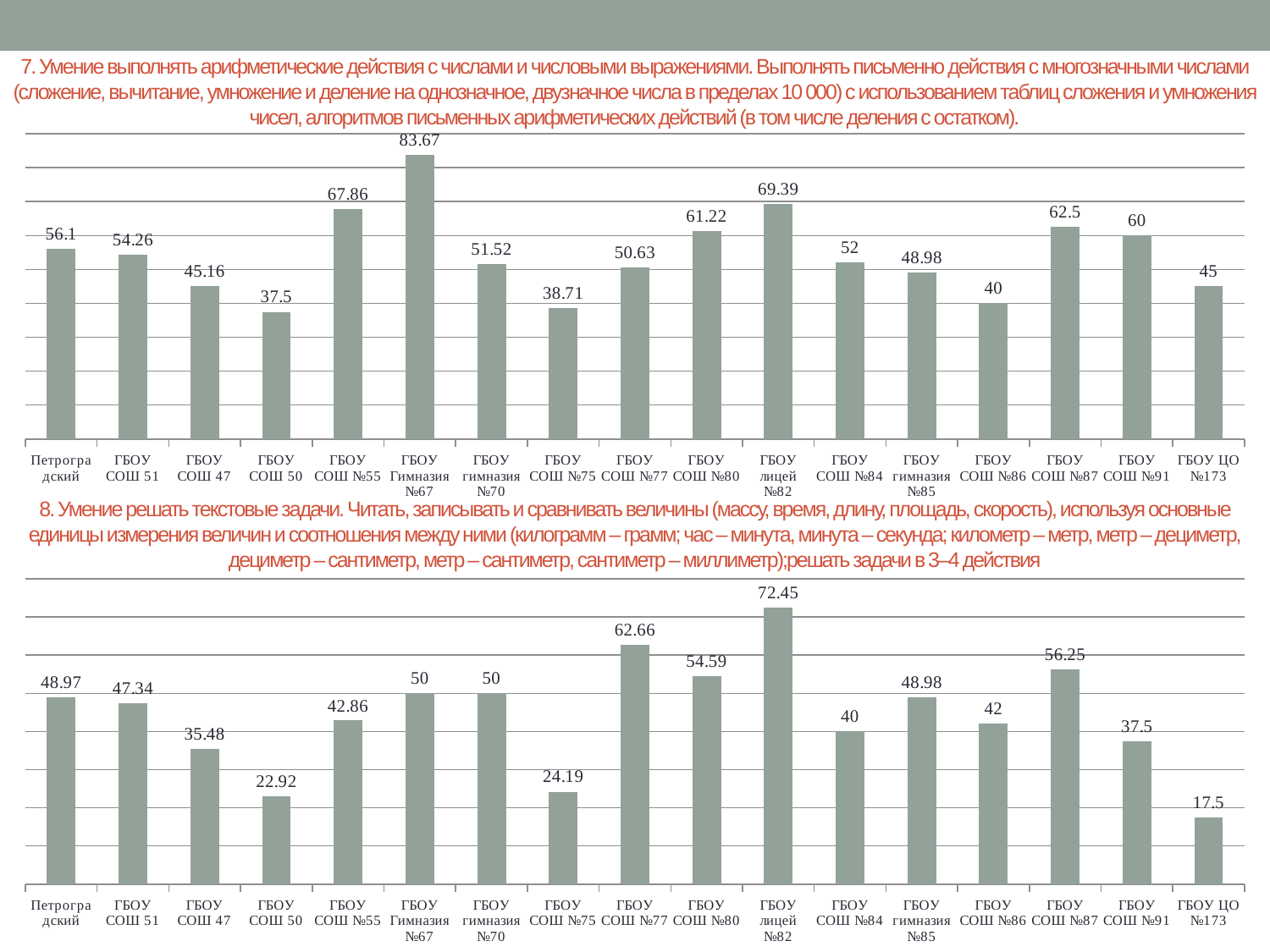
How many schools (categories) are shown in the top chart? 17 In the bottom chart, which school has the lowest value? ГБОУ ЦО №173 In the bottom chart, what is the difference between the values for ГБОУ СОШ №77 and ГБОУ СОШ №75? 38.47 In the top chart, what is the value for ГБОУ Гимназия №67? 83.67 What type of chart is the bottom chart? Bar chart In the top chart, which school has the lowest value? ГБОУ СОШ 50 In the bottom chart, which is larger: the value for ГБОУ СОШ №87 or the value for ГБОУ СОШ №91? ГБОУ СОШ №87 In the bottom chart, what is the value for ГБОУ СОШ 50? 22.92 In the top chart, which is larger: the value for Петроградский or the value for ГБОУ СОШ 51? Петроградский In the bottom chart, which school has the highest value? ГБОУ лицей №82 In the bottom chart, what is the value for ГБОУ ЦО №173? 17.5 In the top chart, what is the difference between the values for ГБОУ лицей №82 and ГБОУ СОШ №80? 8.17